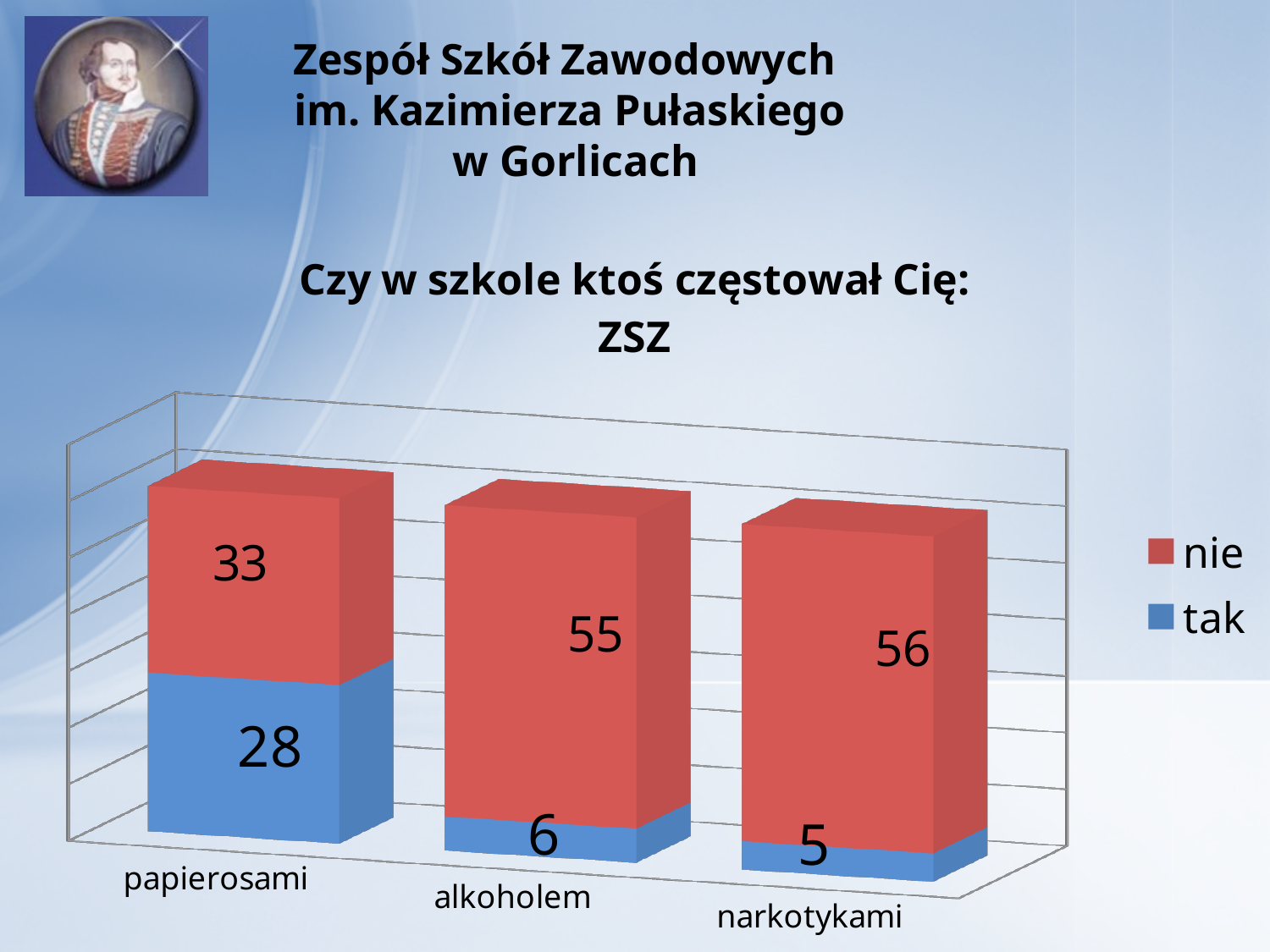
What is the value for "tak" in the papierosami category? 28 What is the value for "nie" in the alkoholem category? 55 What is the total of the stacked bar for alkoholem? 61 Which category has the highest "tak" value? papierosami How many categories are shown on the x axis? 3 What is the value for "tak" in the narkotykami category? 5 What is the difference between the "nie" and "tak" values for papierosami? 5 Which is larger: the "tak" value for alkoholem or the "tak" value for narkotykami? alkoholem What kind of chart is shown on the slide? stacked bar chart Which category has the lowest "nie" value? papierosami What is the value for "nie" in the narkotykami category? 56 How many series does the legend list? 2